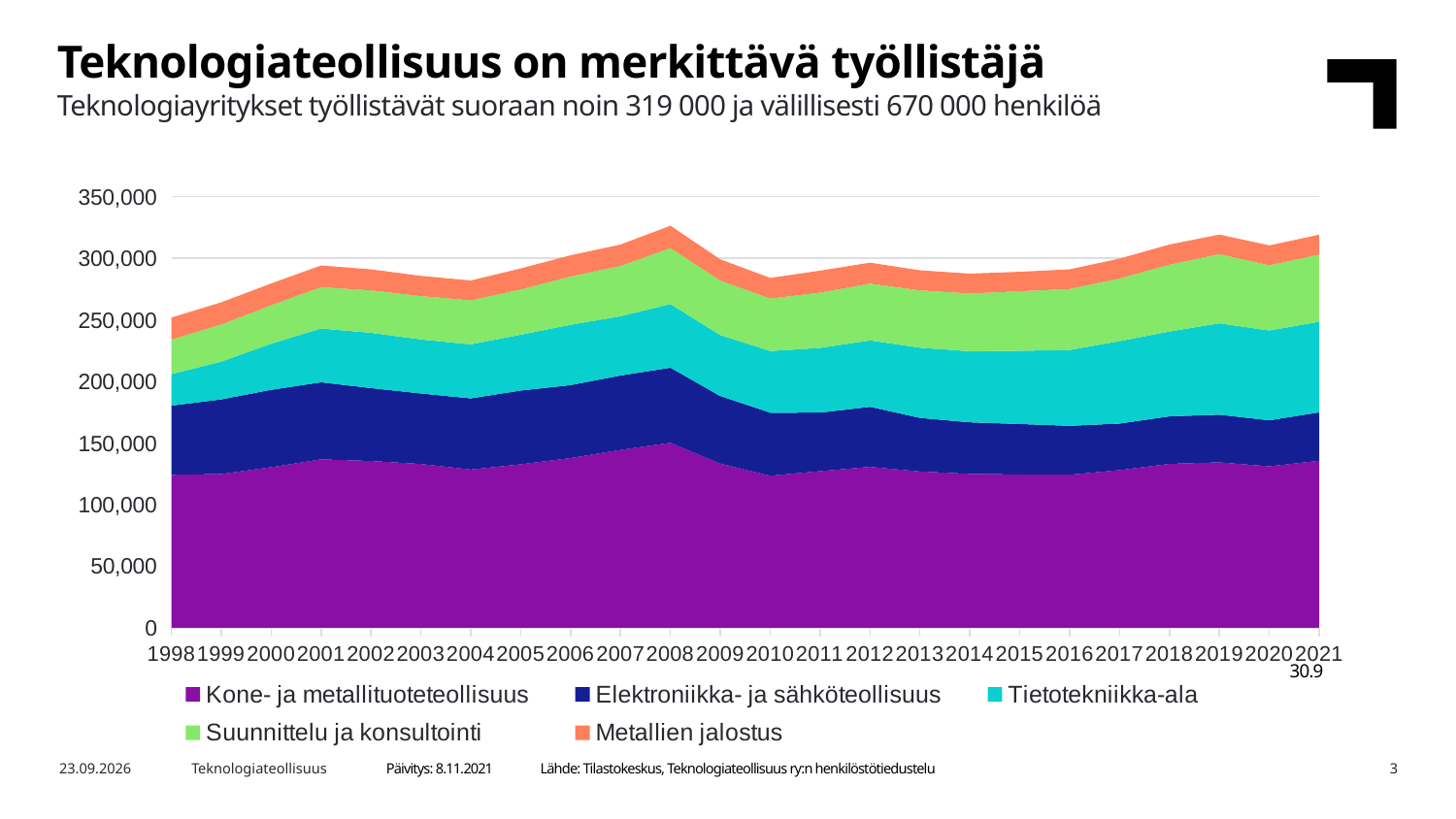
Which series is shown in purple at the bottom of the stack? Kone- ja metallituoteteollisuus Does the total across all series rise or fall from 2008 to 2010? Fall Is the value for Kone- ja metallituoteteollisuus in 1998 greater or less than 100,000? greater Is the total of all series in 2004 greater or less than 300,000? less How many series does the legend list? 5 What kind of chart is shown on the slide? Stacked area chart Is the value for Kone- ja metallituoteteollisuus in 2021 greater or less than 150,000? less Which series has the largest values throughout the period? Kone- ja metallituoteteollisuus Which year is the first on the x axis? 1998 Which year has the lowest total across all series? 1998 How many years are shown along the x axis? 24